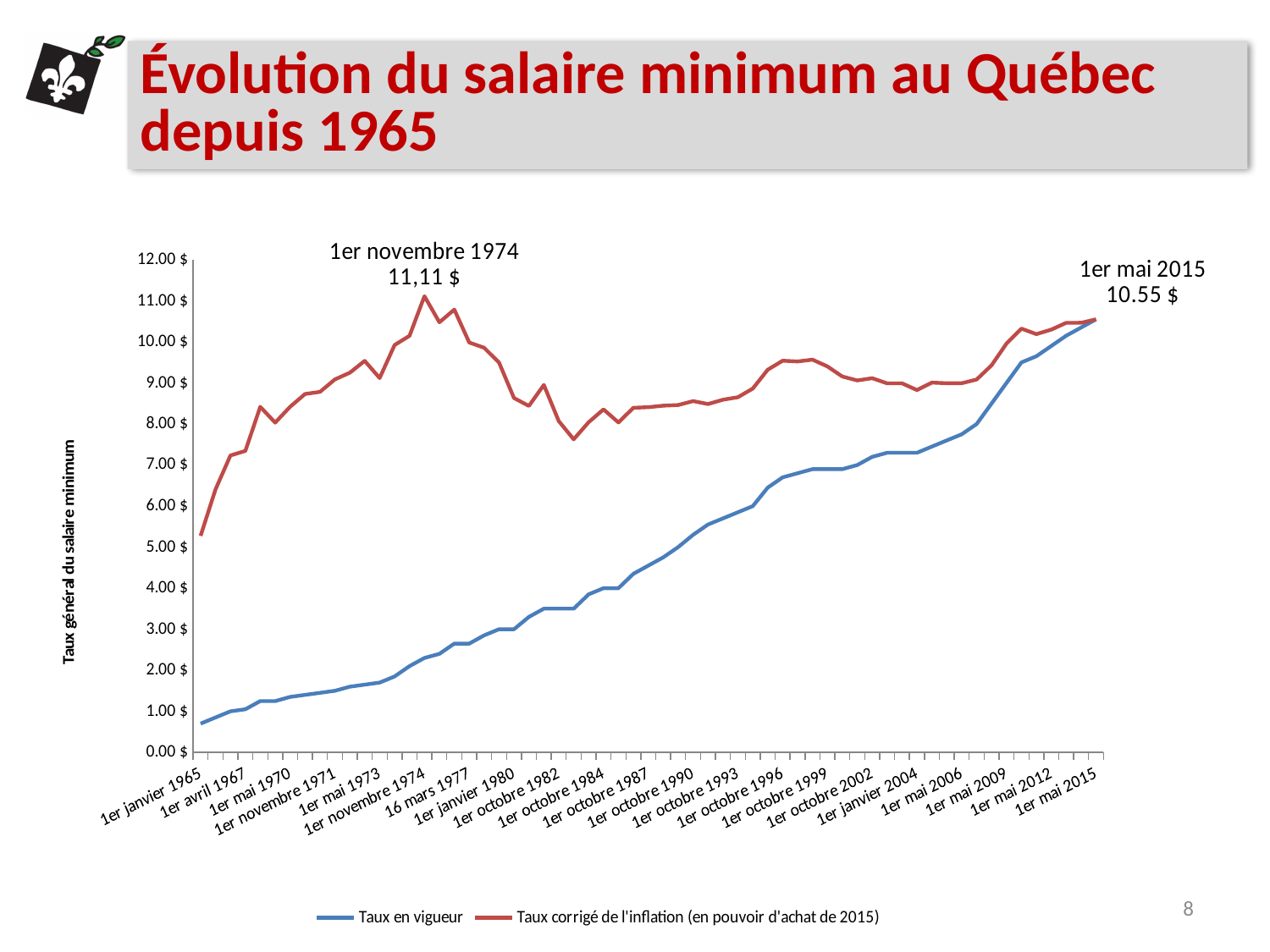
At 1er octobre 1982, which series has the higher value: Taux en vigueur or Taux corrigé de l'inflation? Taux corrigé de l'inflation Which series reaches the highest value on the chart? Taux corrigé de l'inflation (en pouvoir d'achat de 2015) Is the value of Taux corrigé de l'inflation at 1er janvier 1965 greater or less than 5.00 $? greater Is the value of Taux en vigueur at 1er janvier 1965 greater or less than 1.00 $? less Does the Taux en vigueur line generally rise or fall from 1965 to 2015? rise What kind of chart is shown on the slide? line chart What value is annotated for 1er novembre 1974 on the inflation-adjusted line? 11,11 $ Is the value of Taux en vigueur at 1er octobre 1996 greater or less than 6.00 $? greater How many series does the legend list? 2 What value is annotated for 1er mai 2015? 10.55 $ What colour is the Taux en vigueur line? blue